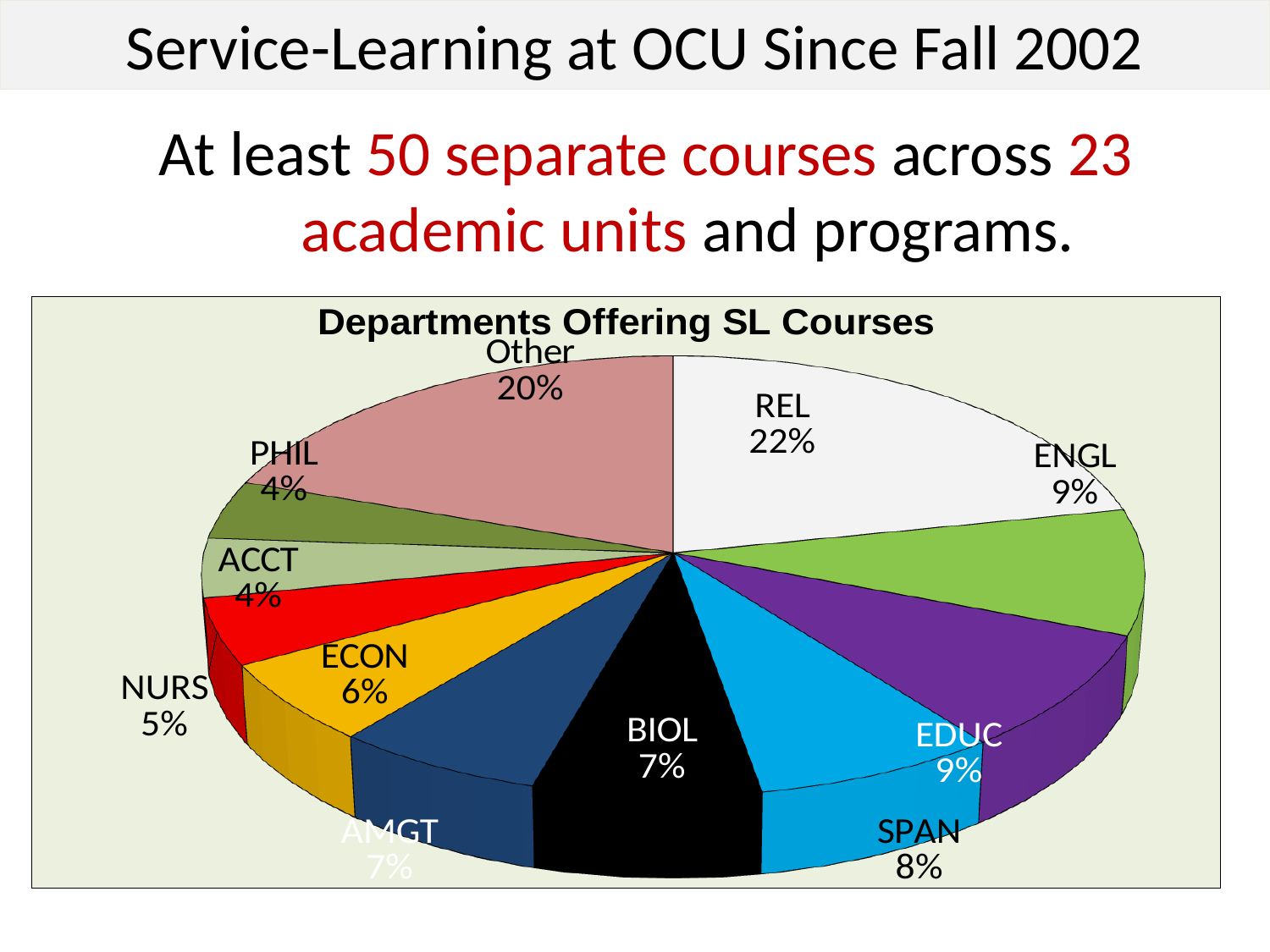
What percentage is shown for the Other slice? 20% Which is larger, the ECON slice or the BIOL slice? BIOL Which named department has the largest slice of the pie? REL What is the difference in percentage points between Other and ECON? 14 How many slices does the pie chart have? 11 What share of the pie does REL account for? 22% What percentage is shown for SPAN? 8% Which is larger, the EDUC slice or the NURS slice? EDUC What is the difference in percentage points between REL and ENGL? 13 What is the title of the chart? Departments Offering SL Courses What type of chart is shown on the slide? Pie chart What percentage is shown for NURS? 5%